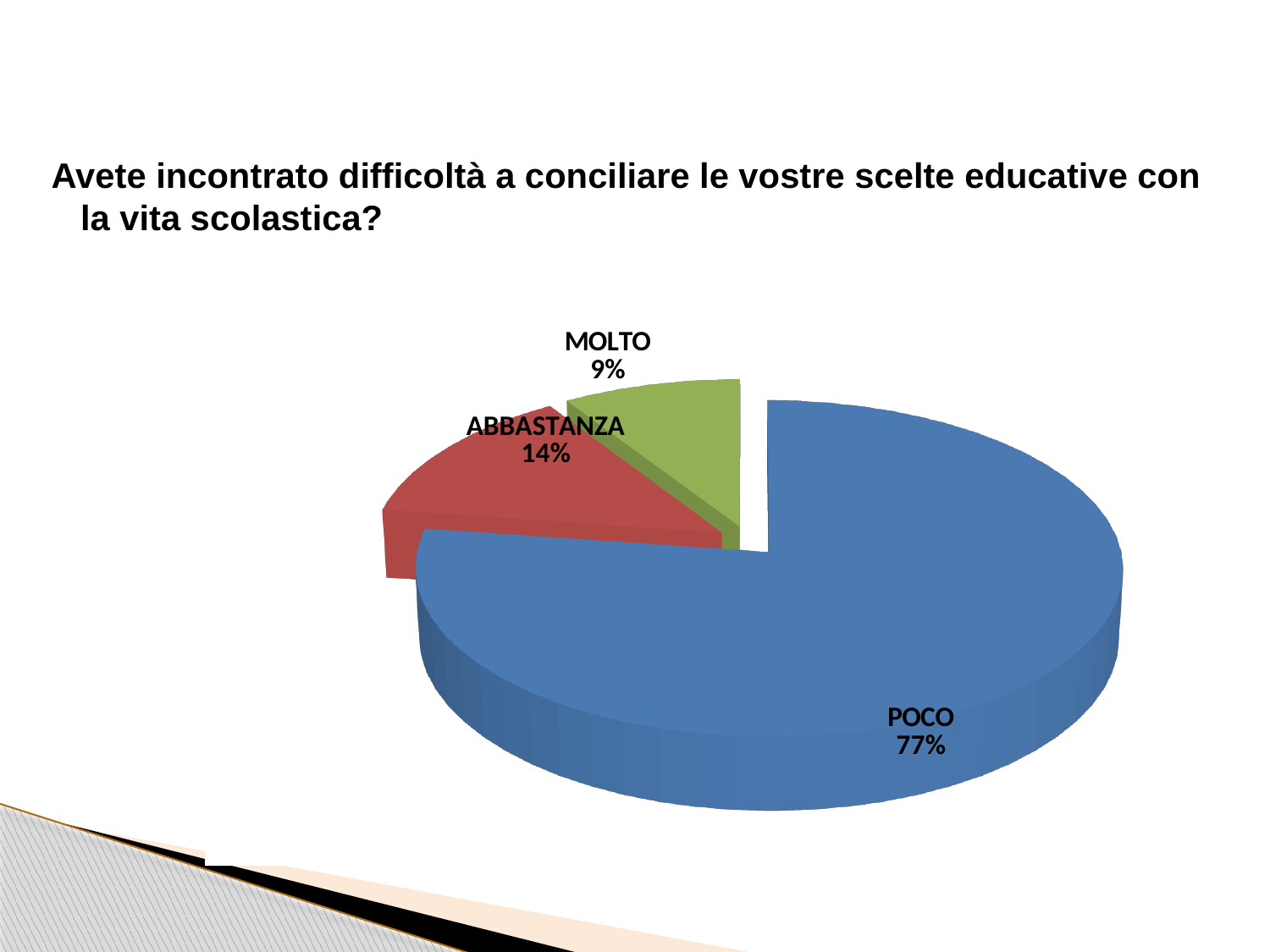
What percentage of the pie is labelled ABBASTANZA? 14% What kind of chart is shown on the slide? pie chart Which slice of the pie is the largest? POCO How many slices does the pie chart have? 3 What colour is the MOLTO slice? green What percentage of the pie is labelled POCO? 77% Which slice is larger, ABBASTANZA or MOLTO? ABBASTANZA What is the difference in percentage points between the ABBASTANZA slice and the MOLTO slice? 5 What percentage of the pie is labelled MOLTO? 9% What is the difference in percentage points between the POCO slice and the ABBASTANZA slice? 63 What colour is the POCO slice? blue Which slice of the pie is the smallest? MOLTO